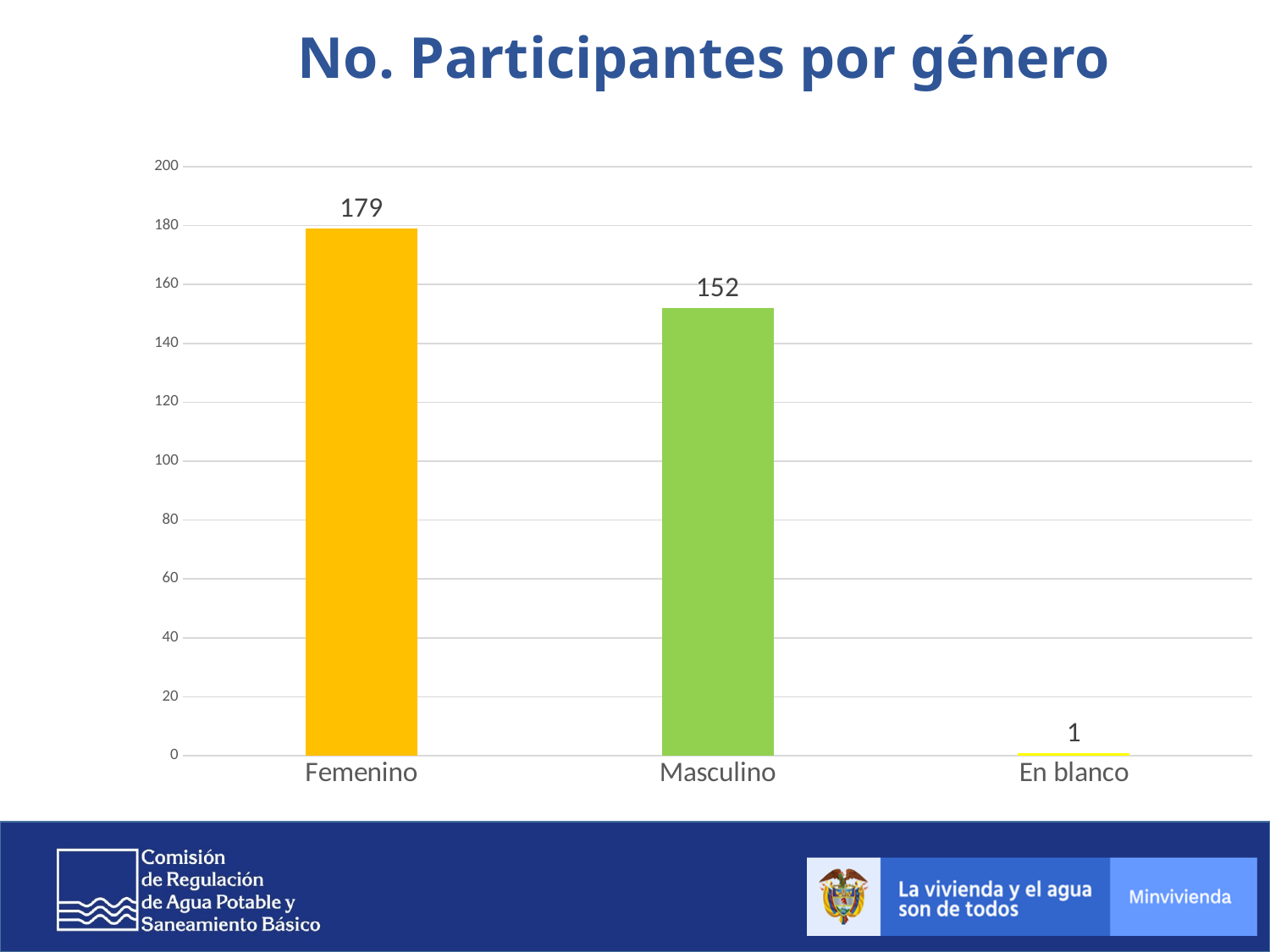
What is the value for Masculino? 152 What colour is the bar for Masculino? Green Which category has the lowest number of participants? En blanco What is the value for En blanco? 1 Which category has the highest number of participants? Femenino Which is larger, the value for Masculino or the value for Femenino? Femenino What is the value for Femenino? 179 How many categories are shown on the x axis? 3 What kind of chart is shown on the slide? Bar chart Is the value for Masculino greater or less than 160? less What is the title of the chart? No. Participantes por género What is the difference between the values for Femenino and Masculino? 27